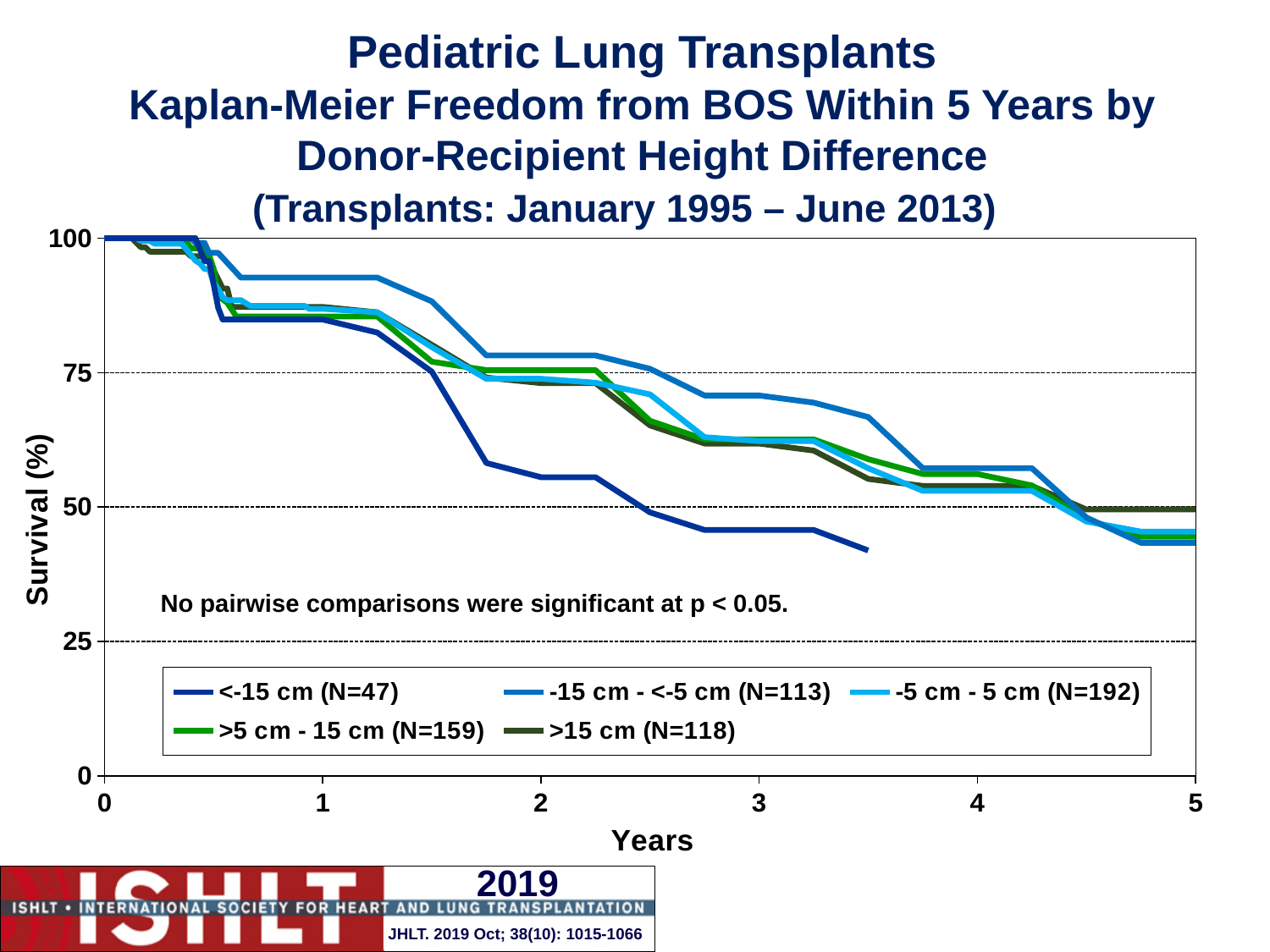
Which group has the lowest survival at year 3? <-15 cm (N=47) What is the N for the -5 cm - 5 cm group in the legend? 192 Is the value for the -15 cm - <-5 cm group at year 3 greater or less than 50? greater Is the value for the <-15 cm group at year 2 greater or less than 75? less Is the value for the -5 cm - 5 cm group at year 5 greater or less than 50? less Do the survival curves rise or fall as years increase? fall How many series does the legend list? 5 At year 2, which is larger: the value for the <-15 cm group or the -15 cm - <-5 cm group? -15 cm - <-5 cm What kind of chart is shown on the slide? line chart What is the survival value for every group at year 0? 100 Which group has the highest survival at year 3? -15 cm - <-5 cm (N=113)